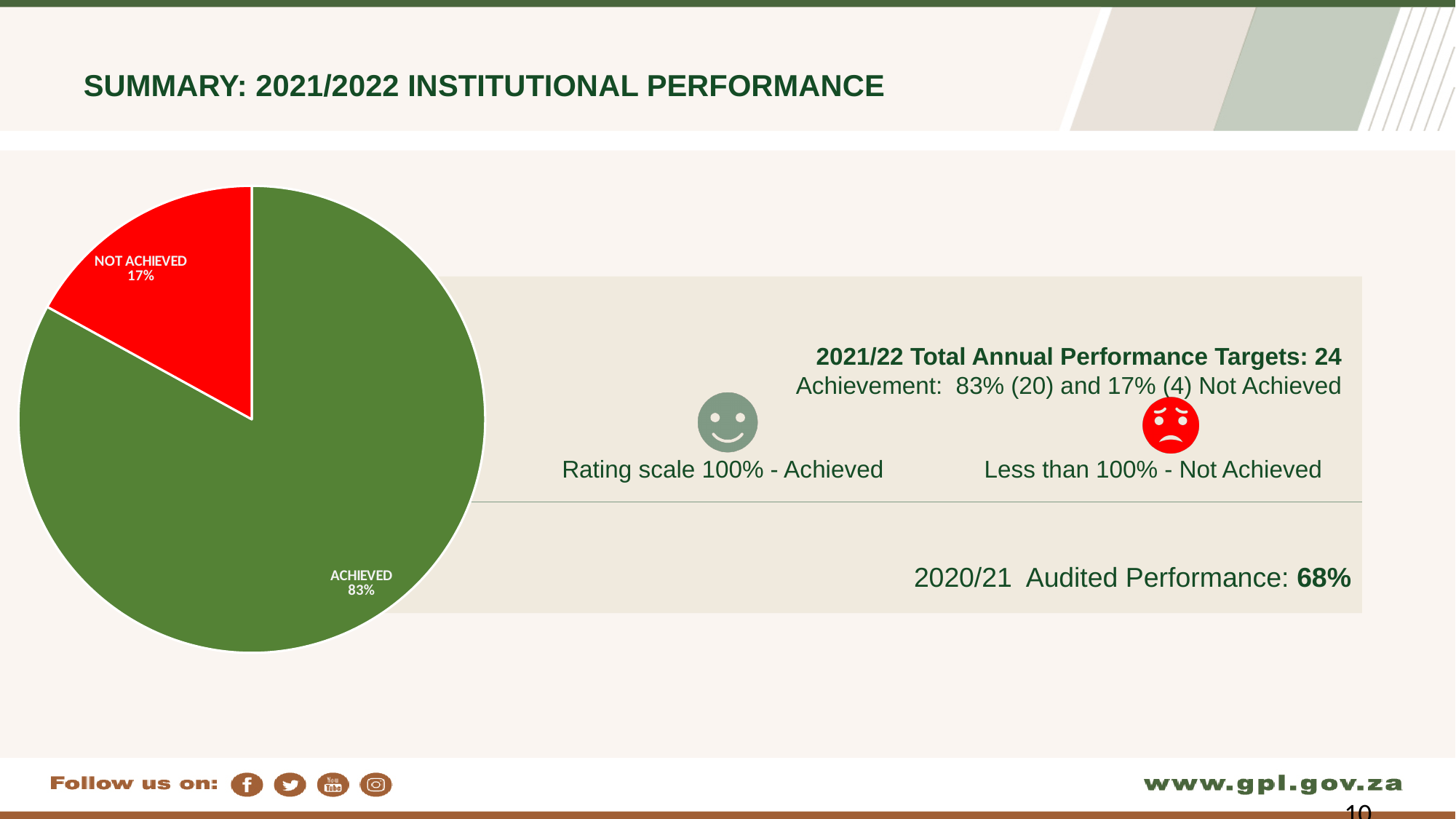
Which slice of the pie is the largest? ACHIEVED Which is larger, the ACHIEVED slice or the NOT ACHIEVED slice? ACHIEVED What percentage of the pie is labelled ACHIEVED? 83% What percentage of the pie is labelled NOT ACHIEVED? 17% What share of the pie does the NOT ACHIEVED slice represent? 17% What is the difference in percentage points between the ACHIEVED and NOT ACHIEVED slices? 66 What colour is the NOT ACHIEVED slice of the pie? red Which slice of the pie is the smallest? NOT ACHIEVED What kind of chart is shown on the slide? pie chart What colour is the ACHIEVED slice of the pie? green How many slices does the pie chart have? 2